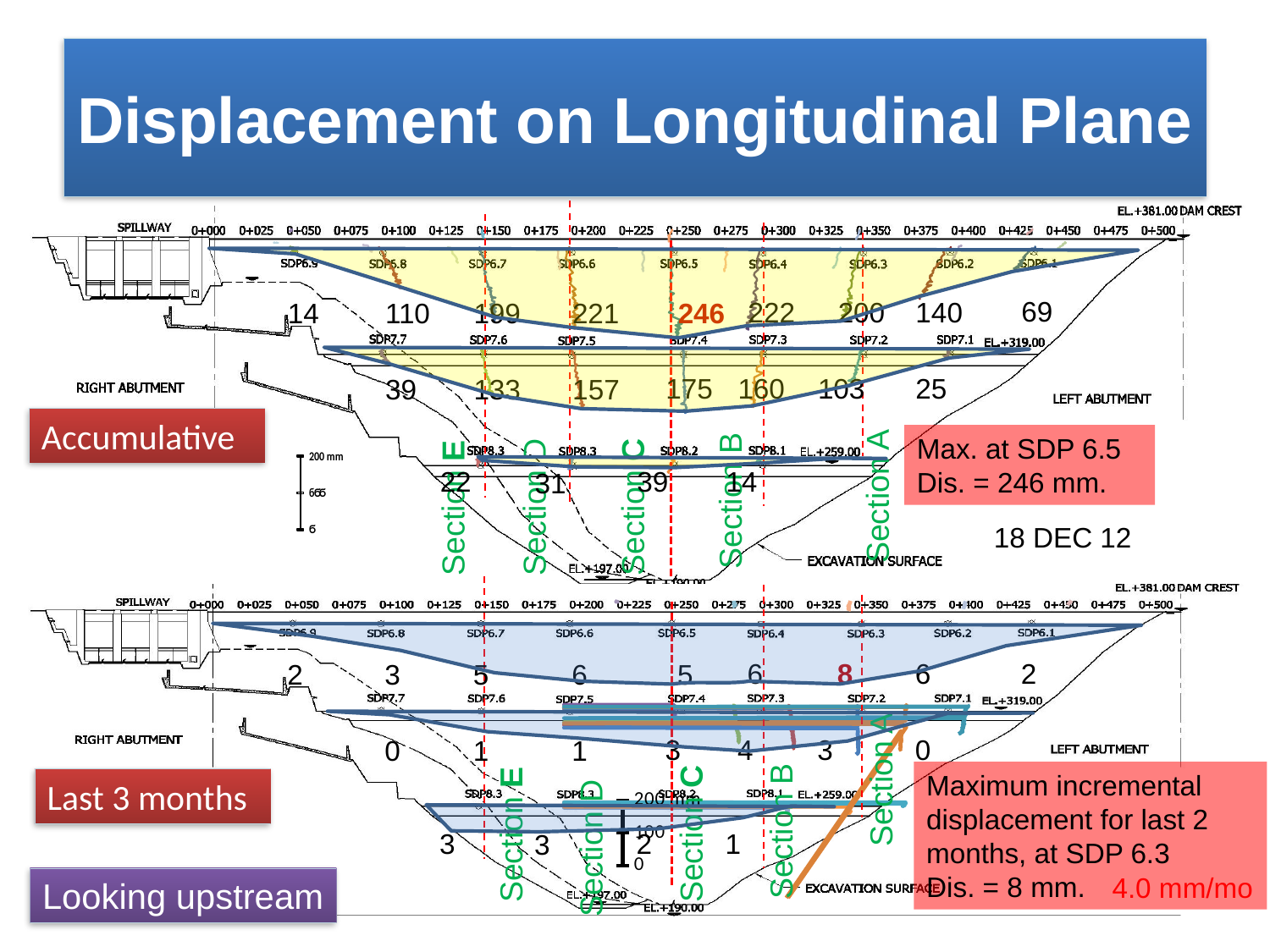
In the Accumulative diagram, which is larger, the value at SDP6.7 (199) or the value at SDP6.3 (200)? SDP6.3 (200) How many displacement values are printed along the SDP6 row of the Last 3 months diagram? 9 In the Accumulative diagram, what is the difference between the values at SDP6.5 (246) and SDP6.4 (222)? 24 In the Accumulative diagram, what is the maximum accumulative displacement and at which instrument does it occur? 246 mm at SDP 6.5 In the Accumulative diagram, what is the displacement value shown at SDP7.4? 175 In the Last 3 months diagram, what is the maximum incremental displacement and at which instrument does it occur? 8 mm at SDP 6.3 In the Accumulative diagram, what is the displacement value shown at SDP6.6? 221 In the Accumulative diagram, what is the displacement value shown at SDP6.1? 69 What date is given for the Accumulative displacement diagram? 18 DEC 12 What is the title of the slide? Displacement on Longitudinal Plane What is the monthly rate of incremental displacement stated on the slide? 4.0 mm/mo In the Accumulative diagram, what is the lowest value shown along the SDP7 row? 25